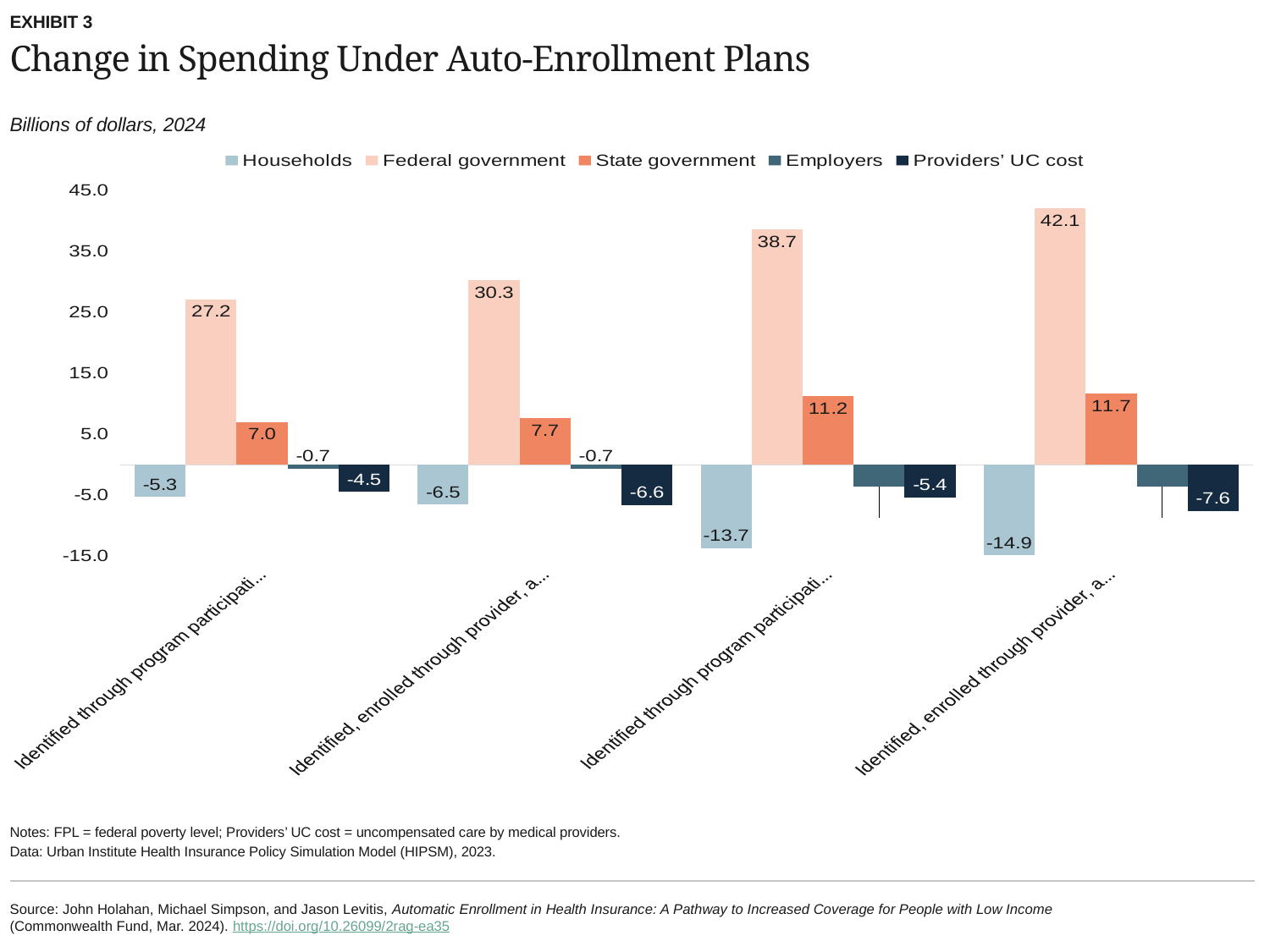
Is the State government value larger in the second or the fourth category group? the fourth group (11.7) How many series does the legend list? 5 Which category group has the lowest Households value? the fourth group from the left (-14.9) What is the Households value for the fourth category group from the left? -14.9 What unit is stated in the subtitle of the chart? Billions of dollars, 2024 What is the State government value for the third category group from the left? 11.2 What is the Federal government value for the first category group from the left? 27.2 How many category groups are plotted along the x axis? 4 What is the difference between the Federal government values of the third and first category groups? 11.5 What type of chart is shown on the slide? bar chart Which category group has the highest Federal government value? the fourth group from the left (42.1) What is the Providers' UC cost value for the second category group from the left? -6.6